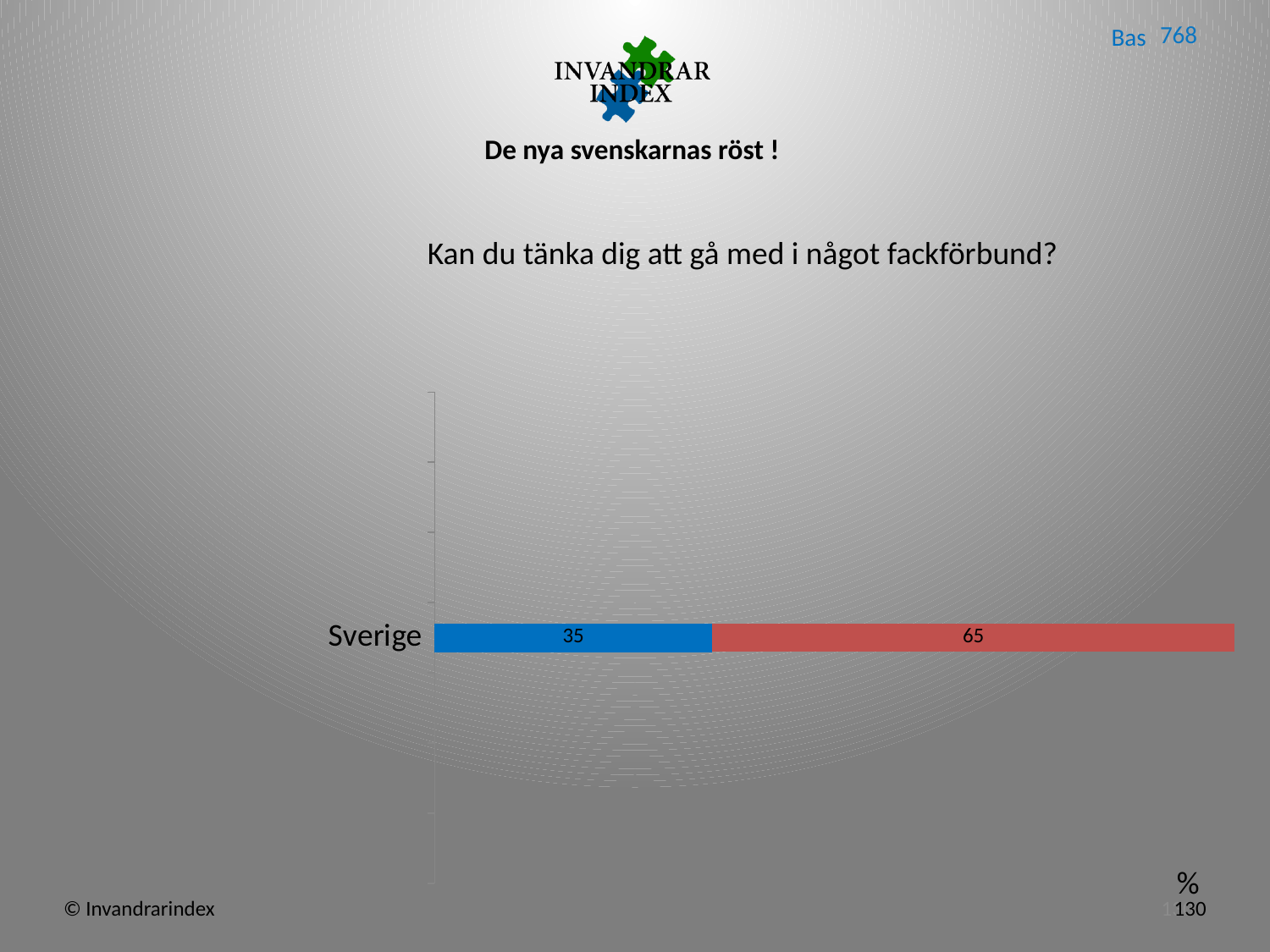
Which segment of the Sverige bar is larger, the blue one or the red one? the red one What is the total of the two segments in the Sverige bar? 100 What question is the chart titled with? Kan du tänka dig att gå med i något fackförbund? How many categories are plotted on the chart? 1 What is the value of the blue segment of the Sverige bar? 35 What is the value of the red segment of the Sverige bar? 65 What is the label of the single category on the chart? Sverige Which segment of the Sverige bar has the lowest value? the blue segment (35) Which segment of the Sverige bar has the highest value? the red segment (65) What is the difference between the red segment (65) and the blue segment (35) of the Sverige bar? 30 What kind of chart is shown on the slide? stacked bar chart